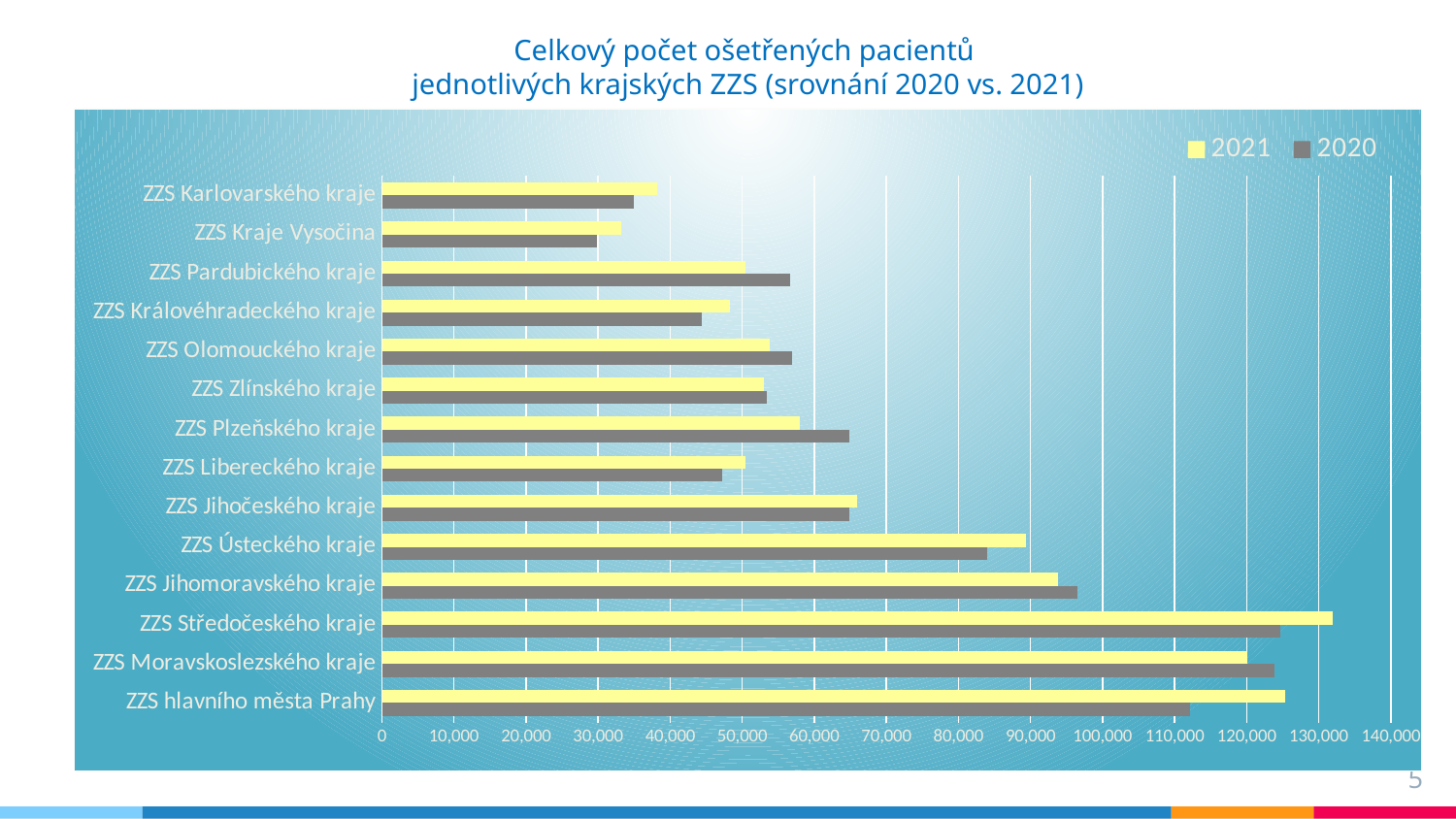
Is the 2021 value for ZZS Karlovarského kraje greater or less than 40,000? less For ZZS Pardubického kraje, which year has the larger value, 2021 or 2020? 2020 Is the 2020 value for ZZS Ústeckého kraje greater or less than 80,000? greater How many series does the legend list? 2 Which ZZS has the lowest value for 2020? ZZS Kraje Vysočina Which ZZS has the highest value for 2021? ZZS Středočeského kraje What kind of chart is shown on the slide? bar chart Which colour represents the 2021 series in the chart? yellow How many regional ZZS organisations (categories) are plotted on the chart? 14 For ZZS hlavního města Prahy, which year has the larger value, 2021 or 2020? 2021 Which ZZS has the lowest value for 2021? ZZS Kraje Vysočina Is the 2020 value for ZZS Plzeňského kraje greater or less than 60,000? greater